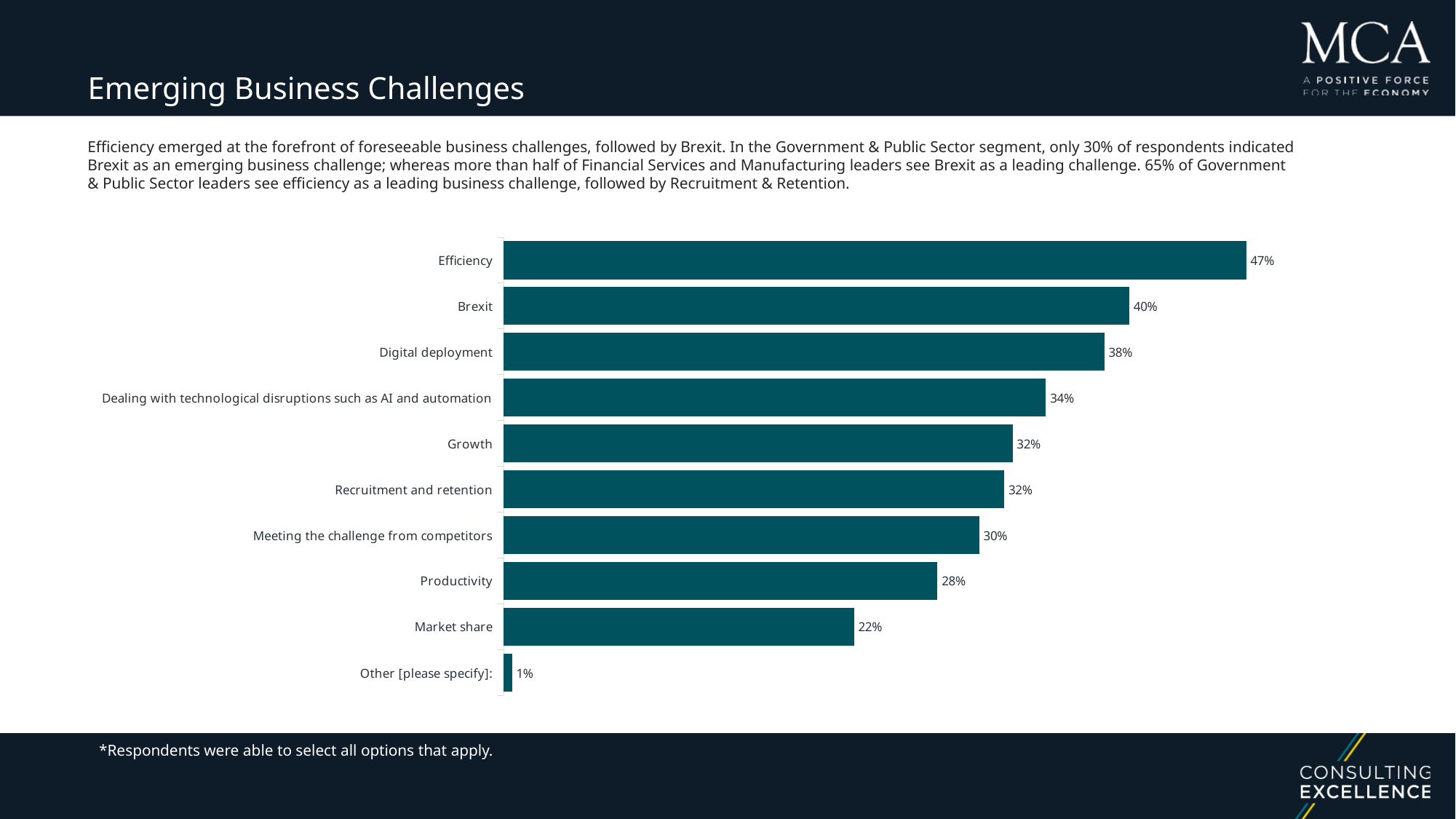
What percentage of respondents selected Efficiency as an emerging business challenge? 47% What is the value shown for Dealing with technological disruptions such as AI and automation? 34% What is the difference between the values for Productivity and Market share? 6% Which category has the lowest value in the chart? Other [please specify]: What type of chart is shown on the slide? Bar chart What percentage is shown for Market share? 22% How many categories are shown in the chart? 10 What is the value shown for Digital deployment? 38% What is the difference between the values for Efficiency and Brexit? 7% What is the value shown for Brexit? 40% Which category has the highest value in the chart? Efficiency Which has a larger value, Digital deployment or Growth? Digital deployment